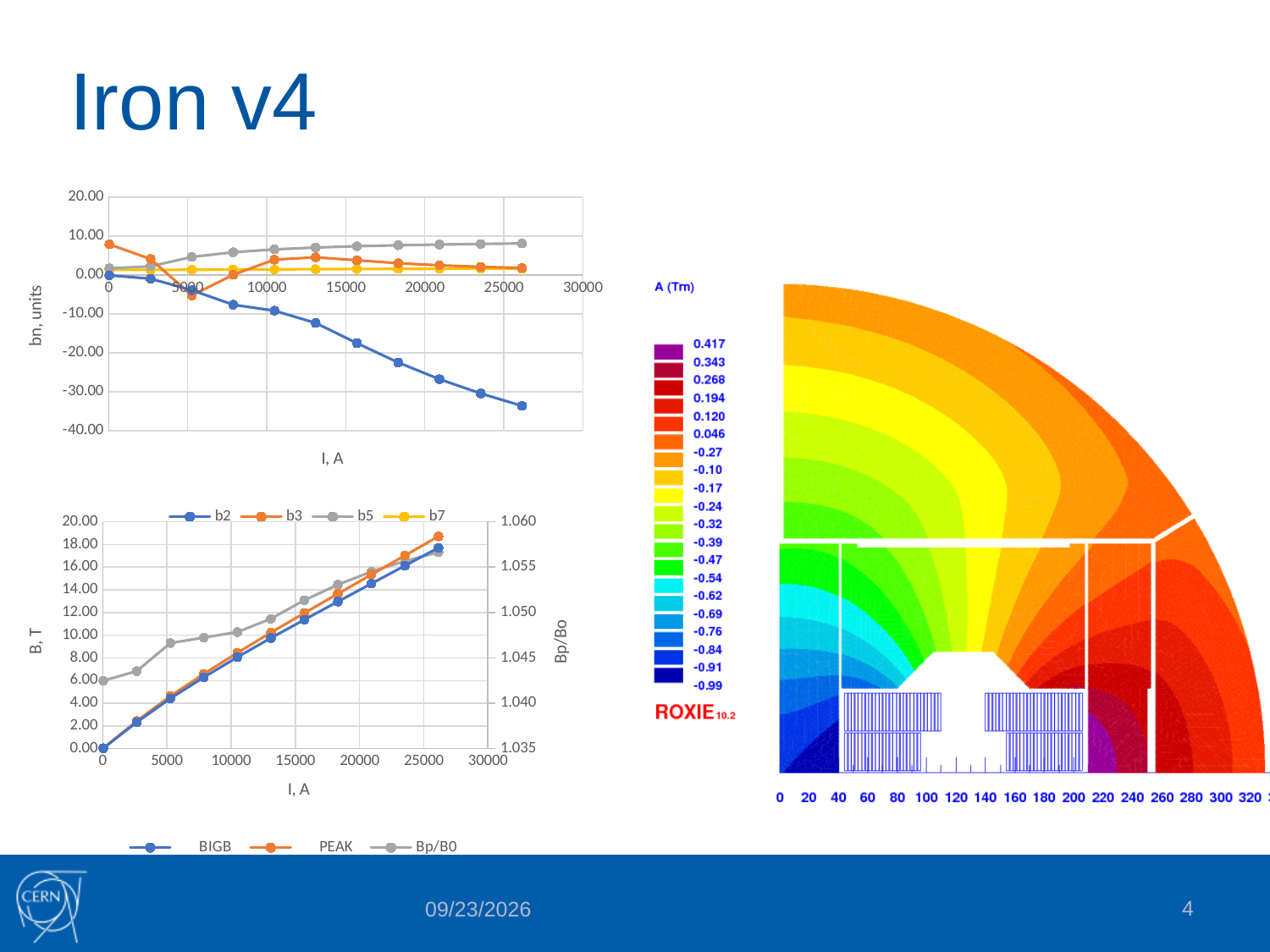
What kind of chart is the top chart on the slide? line chart How many series does the legend of the bottom chart list? 3 In the bottom chart, at the highest current (about 26000 A), which series has the larger value on the left axis, BIGB or PEAK? PEAK In the top chart, does the b2 series rise or fall as I, A increases? fall In the top chart, which series reaches the lowest value? b2 What is the left y-axis title of the bottom chart? B, T How many series does the legend of the top chart list? 4 In the top chart, is the value of b5 at the highest current (about 26000 A) greater or less than 5.00? greater What is the x-axis title of the top chart? I, A In the bottom chart, does the BIGB series rise or fall as I, A increases? rise In the bottom chart, is the value of PEAK at the highest current (about 26000 A) greater or less than 18.00? greater In the top chart, is the value of b2 at the highest current (about 26000 A) greater or less than -30.00? less